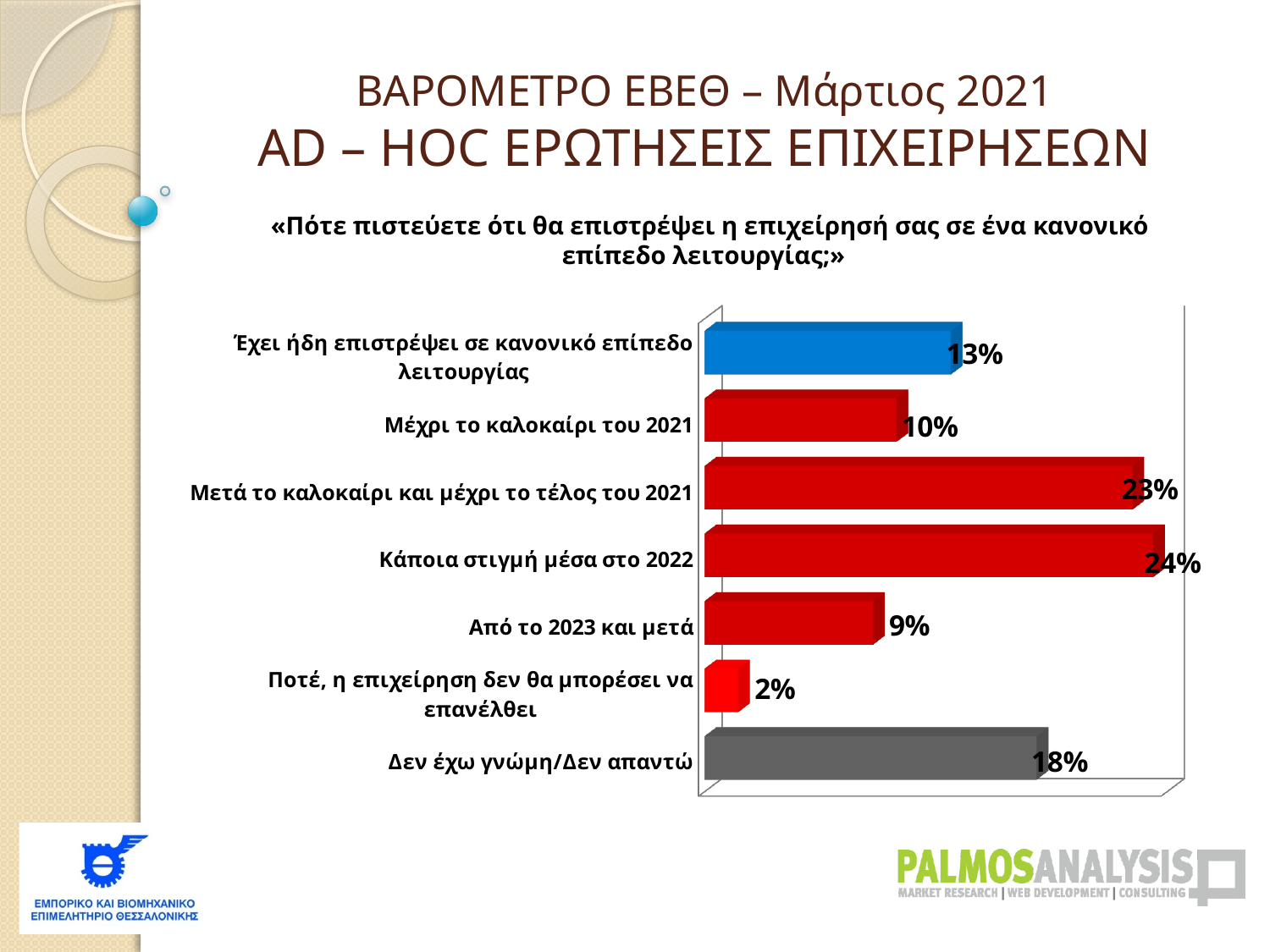
What is the difference in percentage points between «Κάποια στιγμή μέσα στο 2022» and «Ποτέ, η επιχείρηση δεν θα μπορέσει να επανέλθει»? 22 percentage points What type of chart is shown on the slide? Bar chart What is the value for «Από το 2023 και μετά»? 9% What percentage is shown for «Δεν έχω γνώμη/Δεν απαντώ»? 18% How many response categories are shown in the chart? 7 What is the value for «Έχει ήδη επιστρέψει σε κανονικό επίπεδο λειτουργίας»? 13% What colour is the bar for «Δεν έχω γνώμη/Δεν απαντώ»? Grey Which is larger: the value for «Δεν έχω γνώμη/Δεν απαντώ» or the value for «Έχει ήδη επιστρέψει σε κανονικό επίπεδο λειτουργίας»? Δεν έχω γνώμη/Δεν απαντώ Which response category has the highest percentage? Κάποια στιγμή μέσα στο 2022 Which response category has the lowest percentage? Ποτέ, η επιχείρηση δεν θα μπορέσει να επανέλθει What percentage of businesses answered «Κάποια στιγμή μέσα στο 2022»? 24% What is the difference in percentage points between «Μετά το καλοκαίρι και μέχρι το τέλος του 2021» and «Μέχρι το καλοκαίρι του 2021»? 13 percentage points